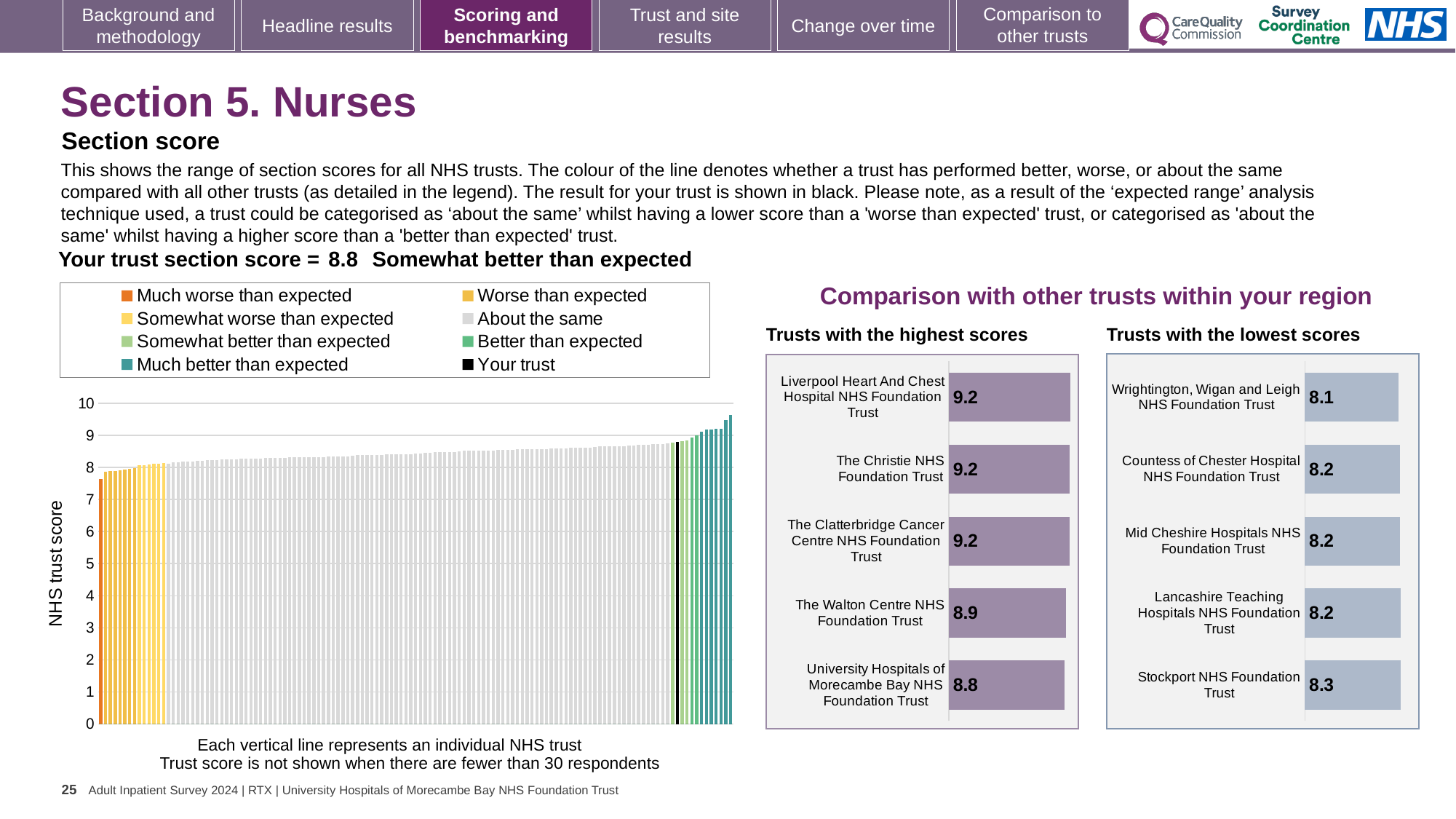
In the 'Trusts with the lowest scores' chart, what is the score for Stockport NHS Foundation Trust? 8.3 In the 'Trusts with the lowest scores' chart, what is the difference between the scores of Stockport NHS Foundation Trust and Wrightington, Wigan and Leigh NHS Foundation Trust? 0.2 In the 'Trusts with the highest scores' chart, which has the higher score: Liverpool Heart And Chest Hospital NHS Foundation Trust or The Walton Centre NHS Foundation Trust? Liverpool Heart And Chest Hospital NHS Foundation Trust In the 'Trusts with the lowest scores' chart, which trust has the lowest score? Wrightington, Wigan and Leigh NHS Foundation Trust In the 'Trusts with the highest scores' chart, what is the score for The Walton Centre NHS Foundation Trust? 8.9 In the main NHS trust score chart on the left, is the value of the lowest (orange) bar greater or less than 8? less In the 'Trusts with the highest scores' chart, which trust has the lowest score shown? University Hospitals of Morecambe Bay NHS Foundation Trust In the 'Trusts with the highest scores' chart, what is the difference between the scores of The Walton Centre NHS Foundation Trust and University Hospitals of Morecambe Bay NHS Foundation Trust? 0.1 How many trusts are listed in the 'Trusts with the lowest scores' chart? 5 What kind of chart is the main NHS trust score chart on the left? bar chart How many entries does the legend of the main NHS trust score chart list? 8 In the main NHS trust score chart on the left, what is the section score for your trust? 8.8